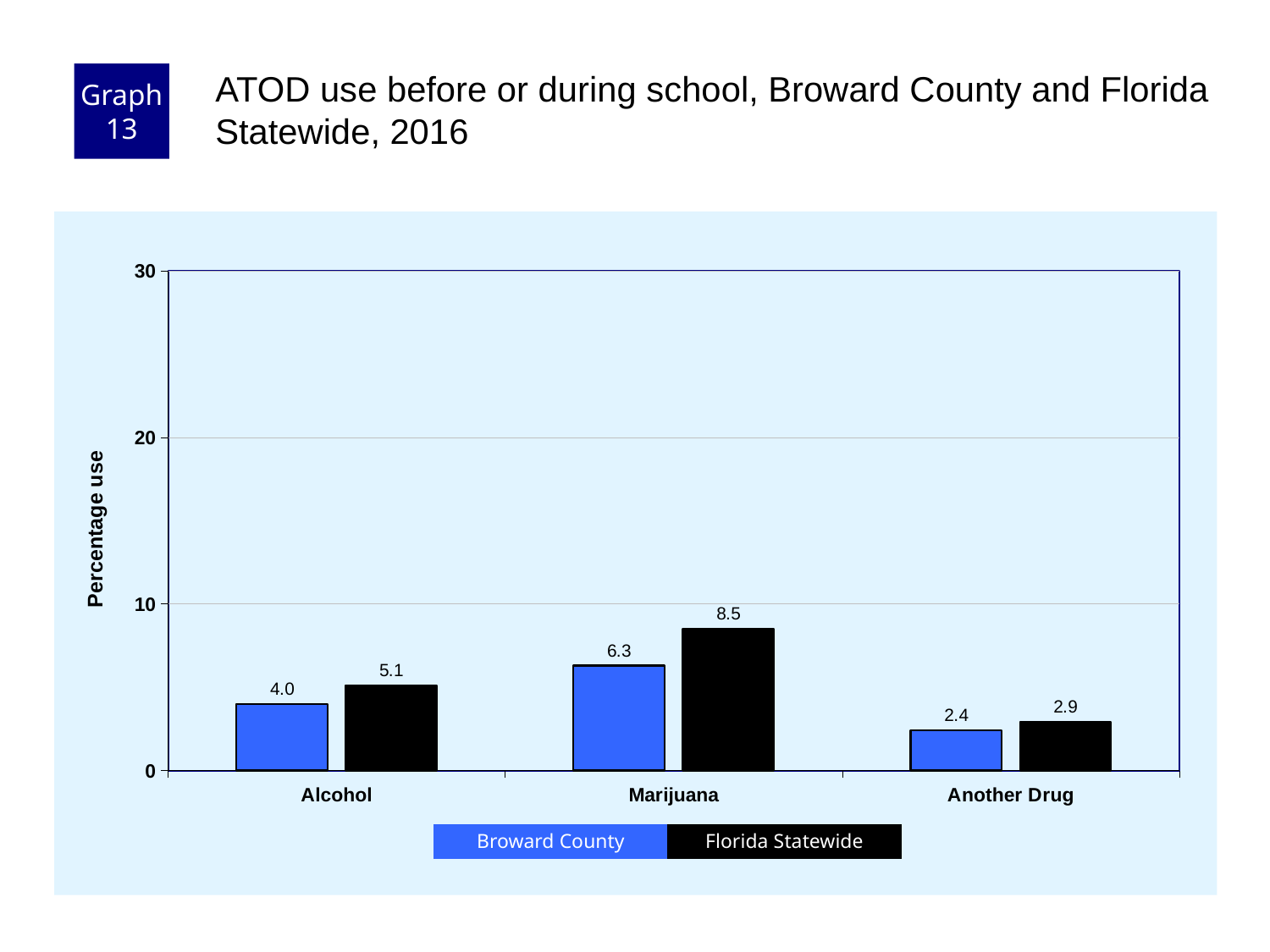
What is the Broward County value for Marijuana? 6.3 Is the Florida Statewide value for Marijuana greater or less than 10? less Which is larger for Another Drug, Broward County or Florida Statewide? Florida Statewide What is the Broward County value for Another Drug? 2.4 Which category has the highest Florida Statewide value? Marijuana What is the difference between the Florida Statewide and Broward County values for Alcohol? 1.1 What kind of chart is shown on the slide? bar chart How many series does the legend list? 2 What is the difference between the Florida Statewide and Broward County values for Marijuana? 2.2 How many categories are shown on the x axis? 3 Which category has the lowest Broward County value? Another Drug What is the Florida Statewide value for Alcohol? 5.1